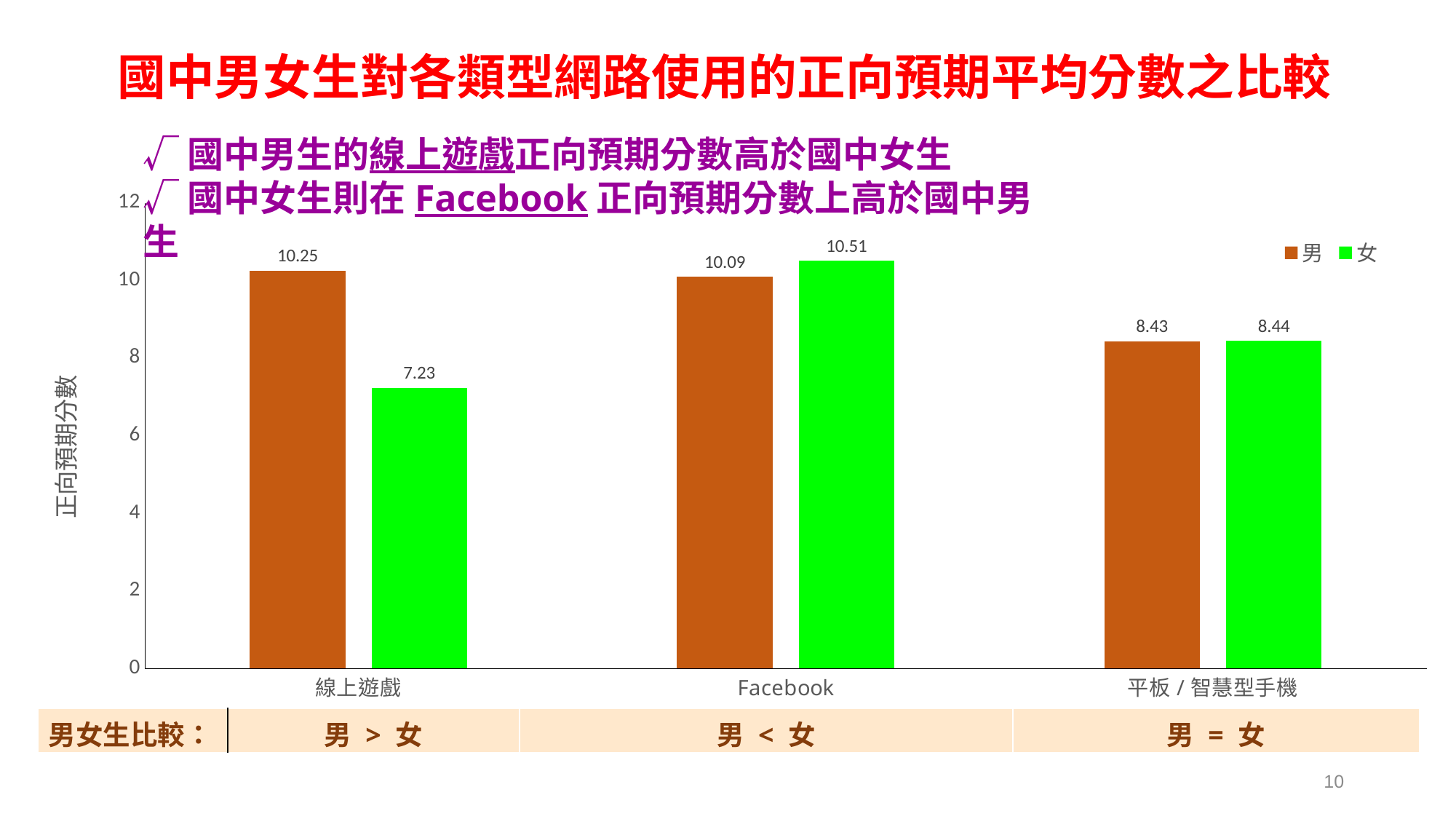
What is the value for 男 in the 平板 / 智慧型手機 category? 8.43 What is the difference between the 女 and 男 values in the Facebook category? 0.42 How many series does the legend list? 2 Which category has the lowest value for the 女 series? 線上遊戲 What is the difference between the 男 and 女 values in the 線上遊戲 category? 3.02 Which category has the highest value for the 女 series? Facebook What is the value for 男 in the 線上遊戲 category? 10.25 What kind of chart is shown on the slide? bar chart How many categories are shown on the x axis? 3 What is the value for 女 in the Facebook category? 10.51 What is the value for 女 in the 線上遊戲 category? 7.23 In the Facebook category, which series has the larger value, 男 or 女? 女